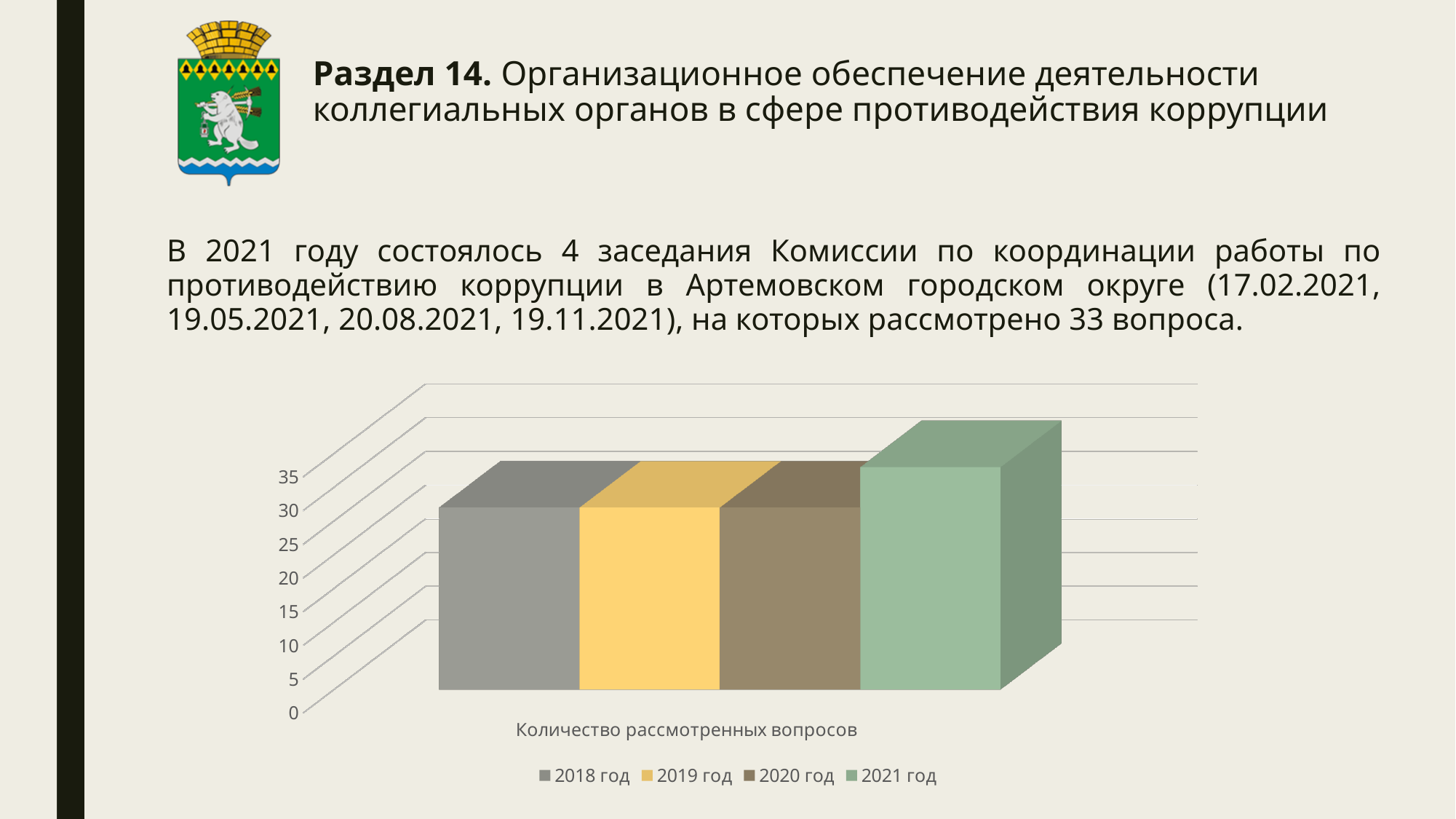
Which year has the highest value for Количество рассмотренных вопросов? 2021 год Which series in the chart is shown in yellow? 2019 год How many categories are shown on the x axis of the chart? 1 Is the value for 2021 год greater or less than 25? greater Which is larger, the value for 2021 год or the value for 2018 год? 2021 год Is the value for 2019 год greater or less than 15? greater Is the value for 2018 год greater or less than 20? greater Which is larger, the value for 2021 год or the value for 2020 год? 2021 год What kind of chart is shown on the slide? bar chart What is the category label shown on the x axis of the chart? Количество рассмотренных вопросов How many series does the chart legend list? 4